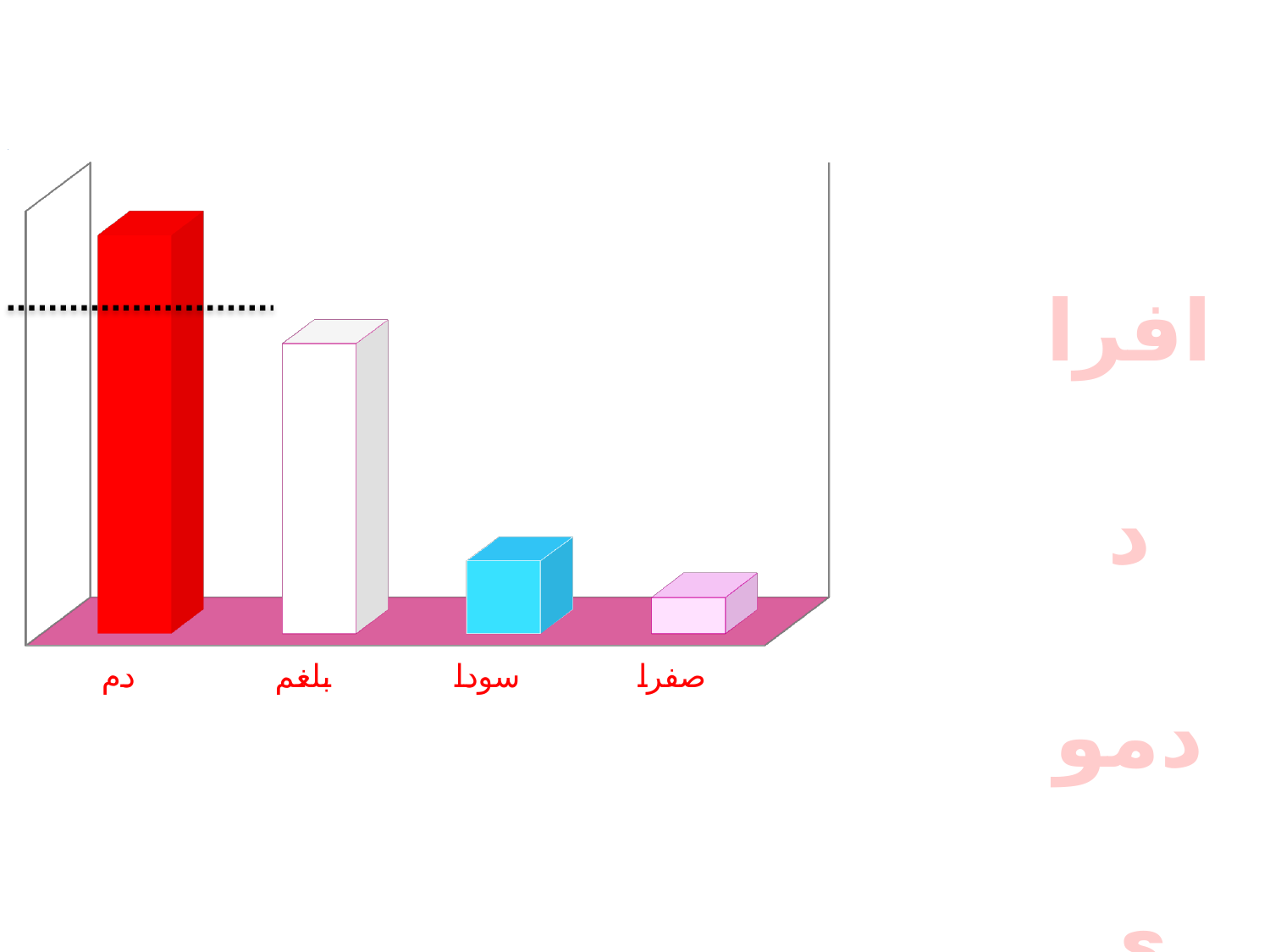
How many categories are plotted on the x axis? 4 Which category is the second highest? بلغم Do the bar values rise or fall from left to right along the x axis? fall What colour is the bar for دم? red Which is larger, the value for دم or the value for بلغم? دم Which category has the lowest bar? صفرا Which is larger, the value for بلغم or the value for سودا? بلغم What colour is the bar for سودا? light blue What kind of chart is shown on the slide? bar chart Which category's bar is the only one that crosses the dotted horizontal line? دم Which category has the highest bar? دم